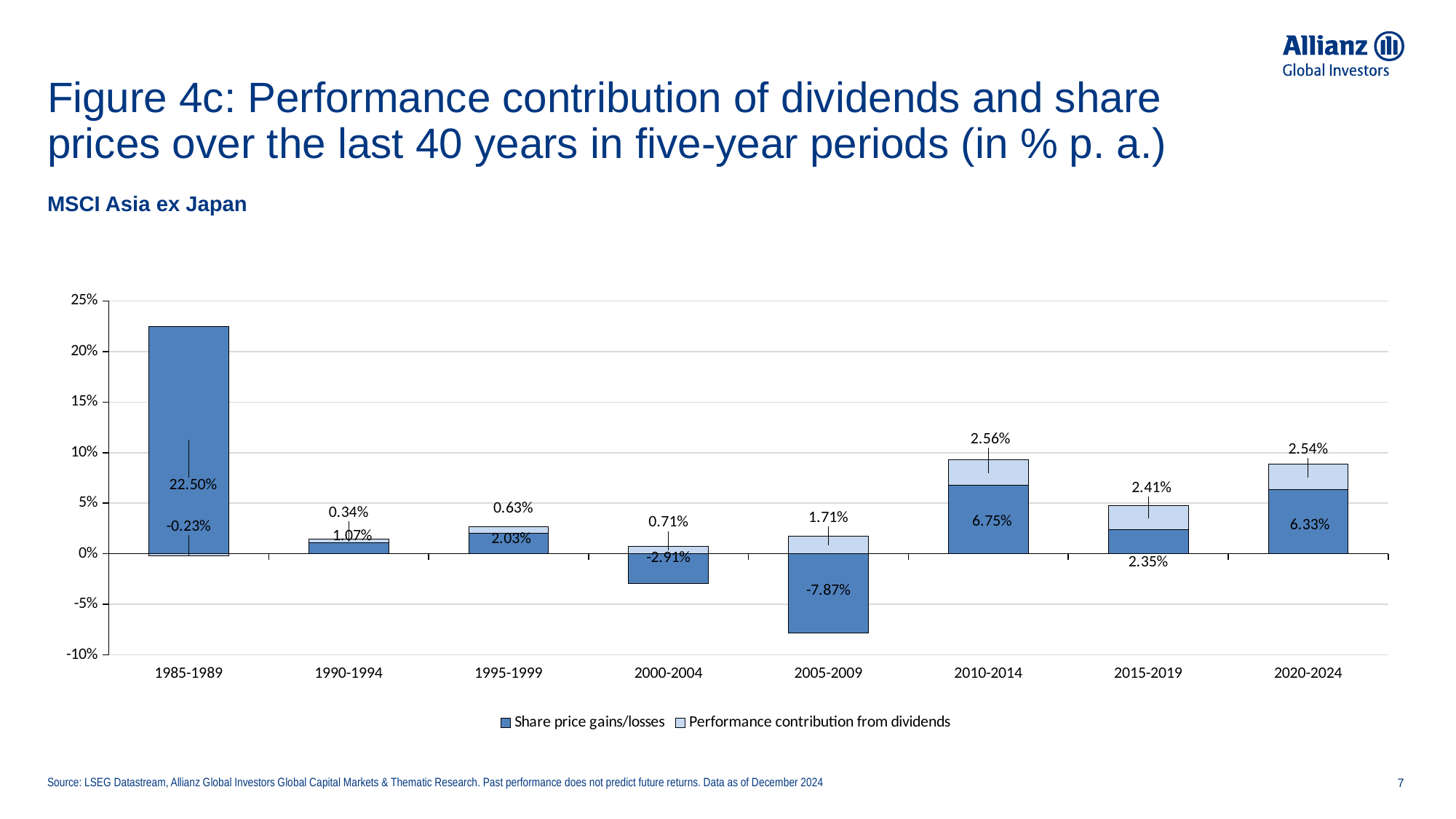
Which is larger: the share price gains/losses for 2010-2014 or for 2020-2024? 2010-2014 What is the total of the stacked bar for 2010-2014? 9.31% What is the difference between the performance contribution from dividends in 2005-2009 and in 2000-2004? 1.00% What is the share price gains/losses value for 2005-2009? -7.87% How many series does the legend list? 2 Which period has the lowest share price gains/losses value? 2005-2009 What is the share price gains/losses value for 1985-1989? 22.50% How many five-year periods are shown on the x axis? 8 Which period has the highest share price gains/losses value? 1985-1989 What is the performance contribution from dividends for 2010-2014? 2.56% What is the performance contribution from dividends for 1985-1989? -0.23% Which period has the lowest performance contribution from dividends? 1985-1989